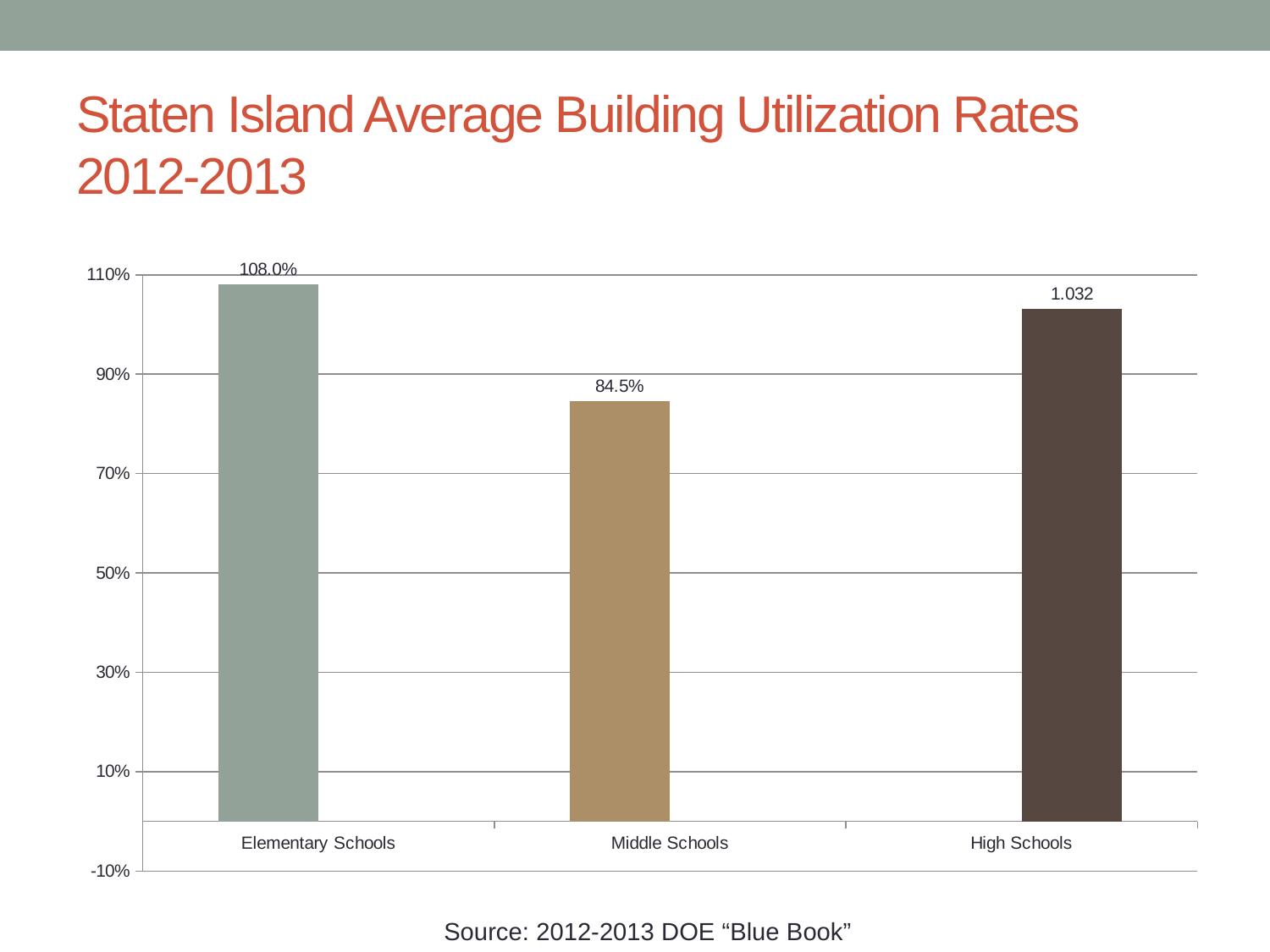
What is the value shown for Elementary Schools? 108.0% Which school type has the lowest average building utilization rate? Middle Schools Is the value for High Schools greater or less than 90%? greater Which school type has the highest average building utilization rate? Elementary Schools How many school types are shown on the chart? 3 What data label is printed above the High Schools bar? 1.032 What source is cited below the chart? 2012-2013 DOE "Blue Book" Which is larger, the value for Elementary Schools or the value for Middle Schools? Elementary Schools Is the value for Middle Schools greater or less than 90%? less What is the difference between the Elementary Schools value and the Middle Schools value? 23.5% What kind of chart is shown on the slide? bar chart What is the value shown for Middle Schools? 84.5%